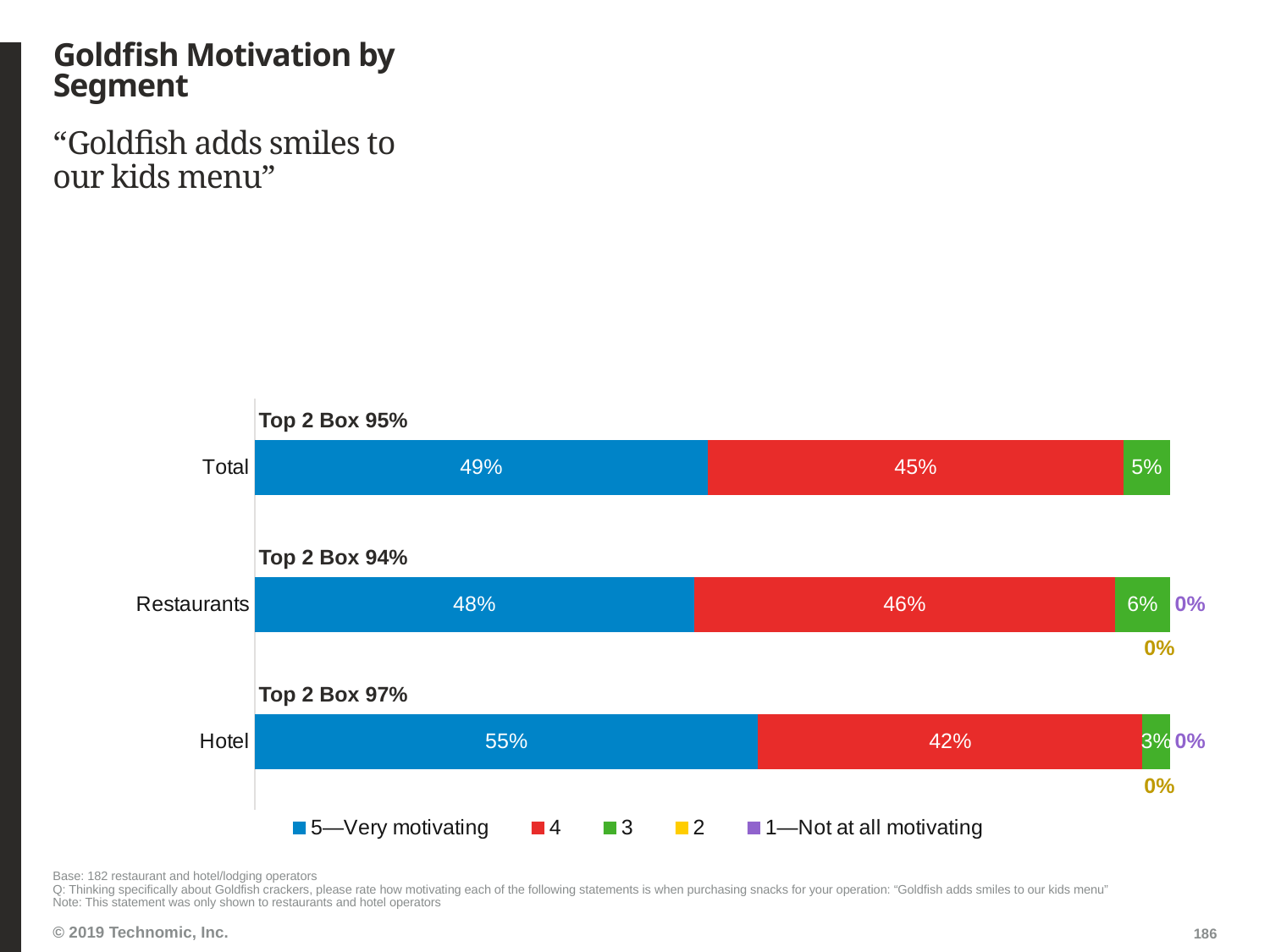
What percentage of Hotel respondents gave a rating of 4? 42% What is the total of the Restaurants bar across the 5, 4 and 3 ratings? 100% Which segment has the lowest value for the 3 rating? Hotel How many series does the legend list? 5 Which segment has the highest value for 5—Very motivating? Hotel What is the Top 2 Box score for Hotel? 97% What is the value for Restaurants in the 3 series? 6% What percentage of Total respondents rated the statement 5—Very motivating? 49% How many segments are shown on the chart? 3 Is the 4 rating value larger for Restaurants or for Hotel? Restaurants What kind of chart is shown on the slide? Stacked bar chart What is the difference between the Hotel and Restaurants values for 5—Very motivating? 7%